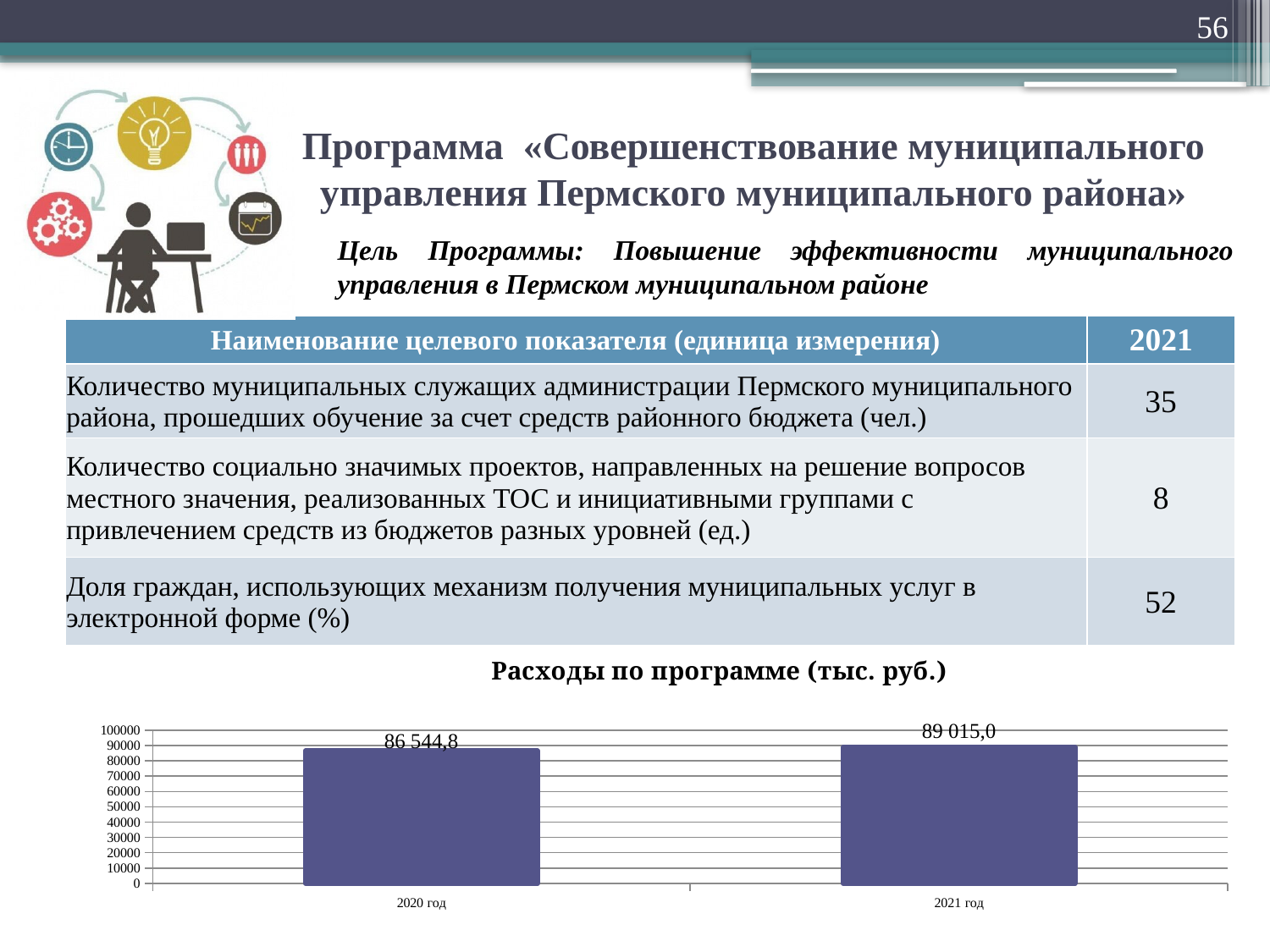
In the chart 'Расходы по программе (тыс. руб.)', which is larger: the value for 2020 год or for 2021 год? 2021 год Do the values in the chart 'Расходы по программе (тыс. руб.)' rise or fall from 2020 год to 2021 год? rise What is the value for 2020 год in the chart 'Расходы по программе (тыс. руб.)'? 86 544,8 Which year has the highest expenditure in the chart 'Расходы по программе (тыс. руб.)'? 2021 год What is the value for 2021 год in the chart 'Расходы по программе (тыс. руб.)'? 89 015,0 How many categories (years) are shown in the chart 'Расходы по программе (тыс. руб.)'? 2 What kind of chart is 'Расходы по программе (тыс. руб.)'? bar chart What is the title of the chart at the bottom of the slide? Расходы по программе (тыс. руб.) Is the value for 2020 год in the chart 'Расходы по программе (тыс. руб.)' greater or less than 80000? greater Is the value for 2021 год in the chart 'Расходы по программе (тыс. руб.)' greater or less than 100000? less Which year has the lowest expenditure in the chart 'Расходы по программе (тыс. руб.)'? 2020 год What is the difference between the 2021 год and 2020 год values in the chart 'Расходы по программе (тыс. руб.)'? 2 470,2